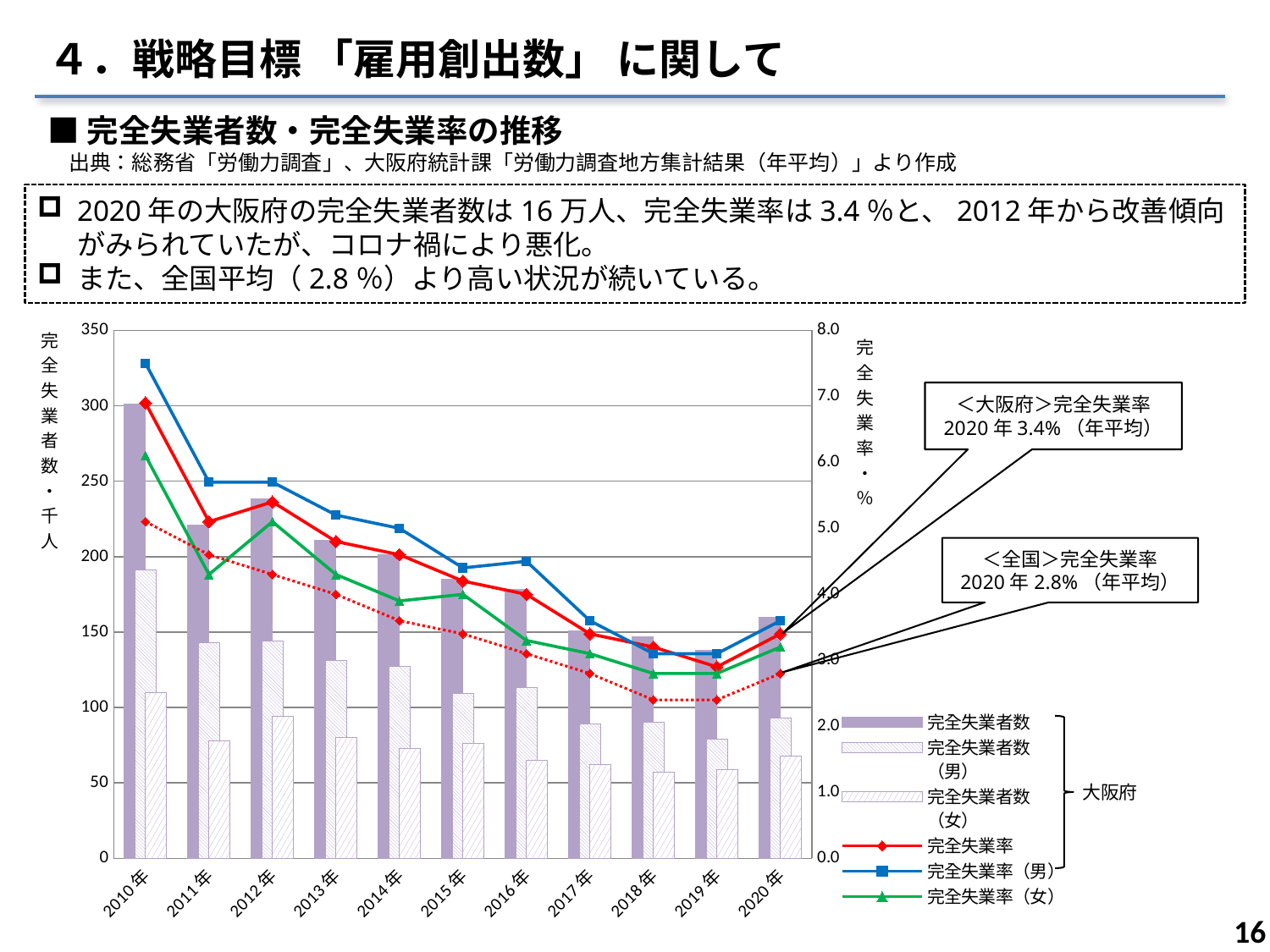
Does the 完全失業率 line rise or fall from 2010年 to 2019年? It falls According to the callout on the chart, what was the national (全国) 完全失業率 in 2020? 2.8% How many years are shown along the x axis of the chart? 11 Is the 完全失業率（男） value for 2020年 greater or less than 3.0? greater How many series does the chart's legend list? 6 In which year is the 完全失業者数 bar the lowest? 2019年 In 2010年, which is higher: 完全失業率（男） or 完全失業率（女）? 完全失業率（男） By how many percentage points did Osaka's 2020 完全失業率 exceed the national 2020 rate, based on the callout values? 0.6 Is the 完全失業者数 value for 2010年 greater or less than 250 (thousand)? greater What kind of chart is shown on the slide? A combined bar and line chart In which year is the 完全失業者数 bar the highest? 2010年 According to the callout on the chart, what was Osaka's 完全失業率 in 2020? 3.4%